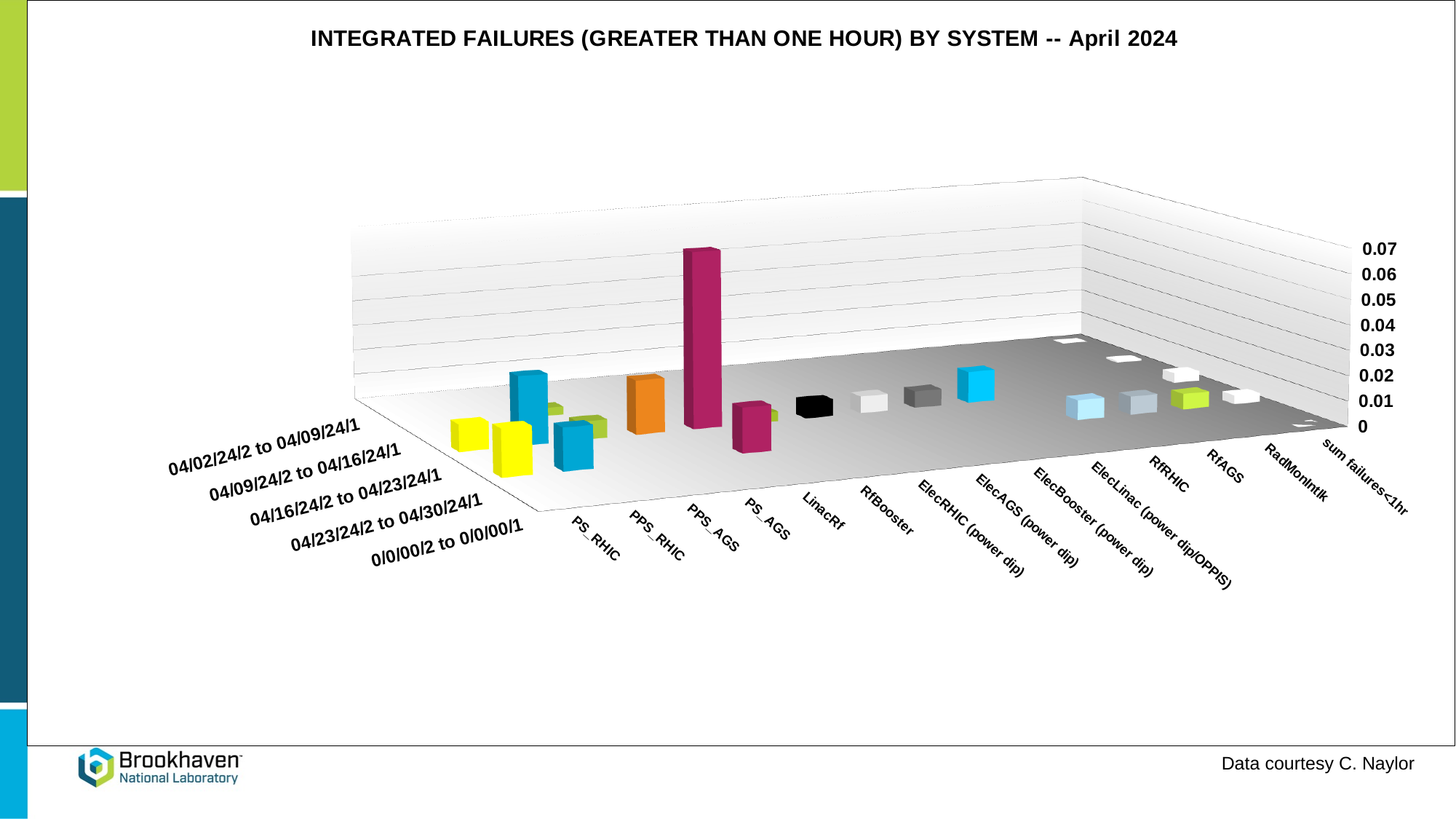
Is the bar for LinacRf greater or less than 0.03? greater Is the tallest bar for PPS_AGS greater or less than 0.03? less What is the highest value shown on the vertical axis? 0.07 What kind of chart is shown on the slide? bar chart Which has the taller bar, PPS_AGS or LinacRf? LinacRf What is the title of the chart? INTEGRATED FAILURES (GREATER THAN ONE HOUR) BY SYSTEM -- April 2024 Which has the taller bar, PPS_AGS or PS_AGS? PS_AGS How many date-range rows are listed along the depth axis of the chart? 5 Which system has the tallest bar in the chart? LinacRf How many system categories are listed along the horizontal axis of the chart? 14 What is the label of the last category on the horizontal axis? sum failures<1hr